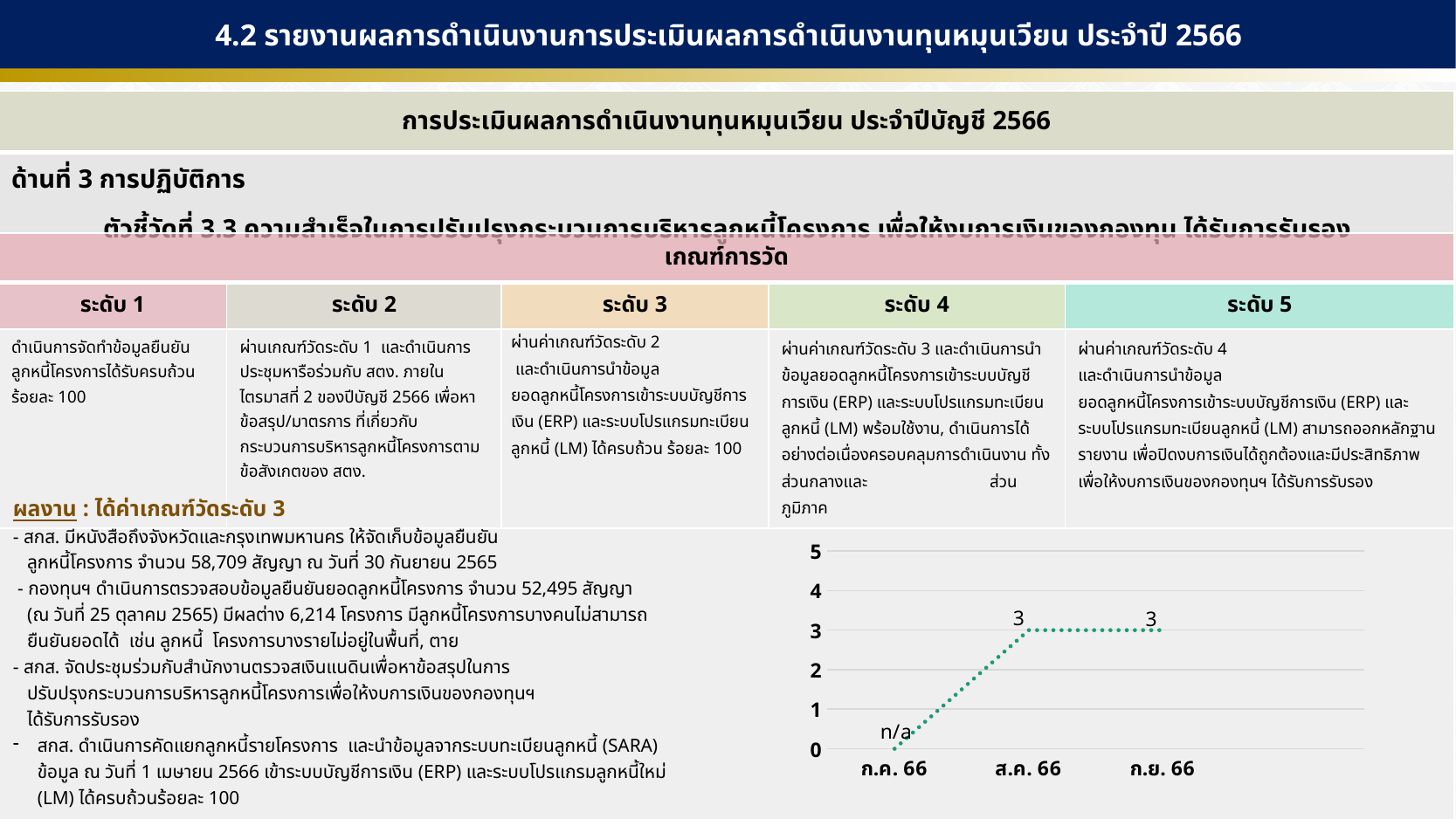
How many categories are shown on the x axis of the chart? 3 What is the value plotted for ก.ย. 66? 3 What label is shown at the data point for ก.ค. 66? n/a Which category is the first on the x axis of the chart? ก.ค. 66 What is the value plotted for ส.ค. 66? 3 What type of chart is shown on the slide? line chart What is the difference between the values for ส.ค. 66 and ก.ย. 66? 0 Is the value for ก.ย. 66 greater or less than 4? less Does the line rise or fall from ก.ค. 66 to ส.ค. 66? rise Is the value for ส.ค. 66 greater or less than 2? greater What is the highest value shown on the y axis of the chart? 5 Does the line rise, fall, or stay flat between ส.ค. 66 and ก.ย. 66? stays flat